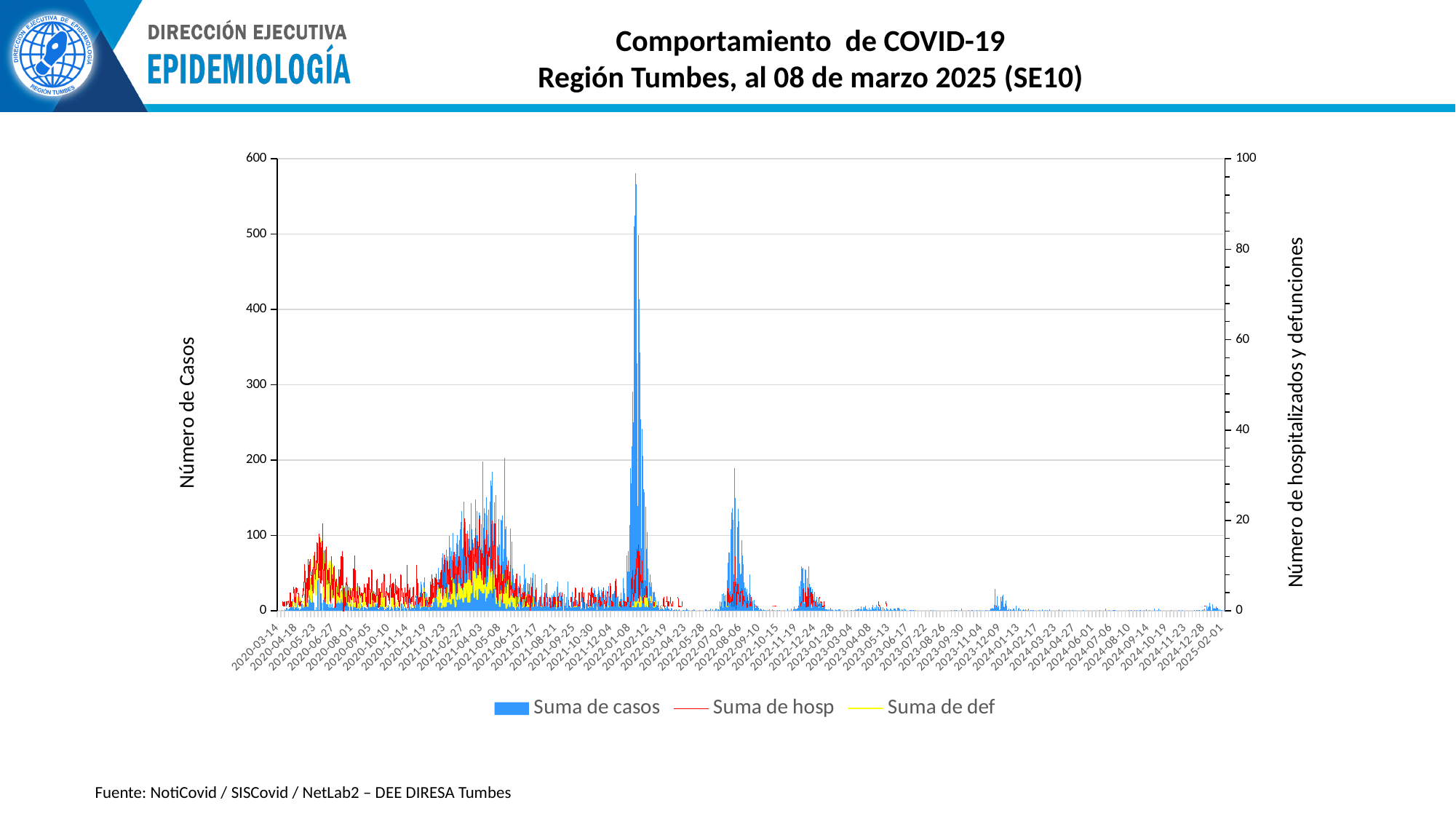
What is the title of the chart on the slide? Comportamiento de COVID-19 Región Tumbes, al 08 de marzo 2025 (SE10) What is the highest tick value shown on the left vertical axis? 600 What kind of chart is shown on the slide? Combined bar and line chart Which series is drawn as blue bars in the chart? Suma de casos What is the label of the right vertical axis? Número de hospitalizados y defunciones What is the highest tick value shown on the right vertical axis? 100 After the peak in early 2022, do the Suma de casos values generally rise or fall through 2023 and 2024? fall Around which period does the Suma de casos series reach its highest peak? Early 2022 (January 2022, just after the 2022-01-08 tick) Is the highest peak of Suma de casos greater or less than 400? greater How many series does the chart legend list? 3 Is the peak of Suma de casos around 2022-08-06 greater or less than 200? less What is the label of the left vertical axis? Número de Casos